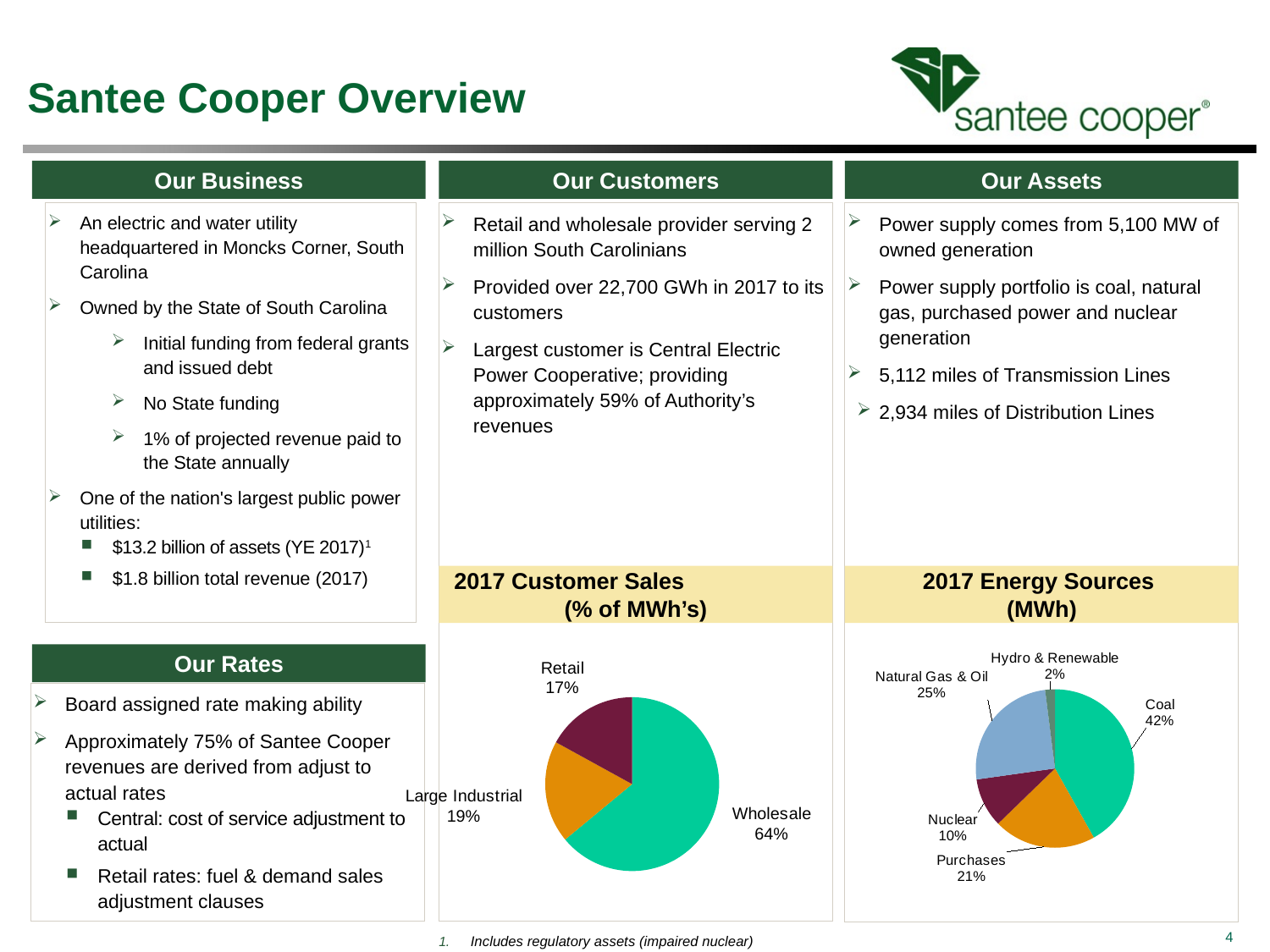
In the 2017 Customer Sales chart, what share of MWh's is Wholesale? 64% In the 2017 Customer Sales chart, how many categories are shown? 3 In the 2017 Energy Sources chart, what is the difference between the Coal and Nuclear shares? 32% What kind of chart is the 2017 Energy Sources chart? Pie chart In the 2017 Customer Sales chart, what is the difference between the Wholesale and Retail shares? 47% In the 2017 Energy Sources chart, what share is Natural Gas & Oil? 25% In the 2017 Customer Sales chart, what share is Large Industrial? 19% In the 2017 Energy Sources chart, how many energy sources are shown? 5 In the 2017 Energy Sources chart, which is larger, Purchases or Nuclear? Purchases In the 2017 Customer Sales chart, which category has the smallest share? Retail In the 2017 Energy Sources chart, which source has the smallest share? Hydro & Renewable In the 2017 Energy Sources chart, what share is Coal? 42%